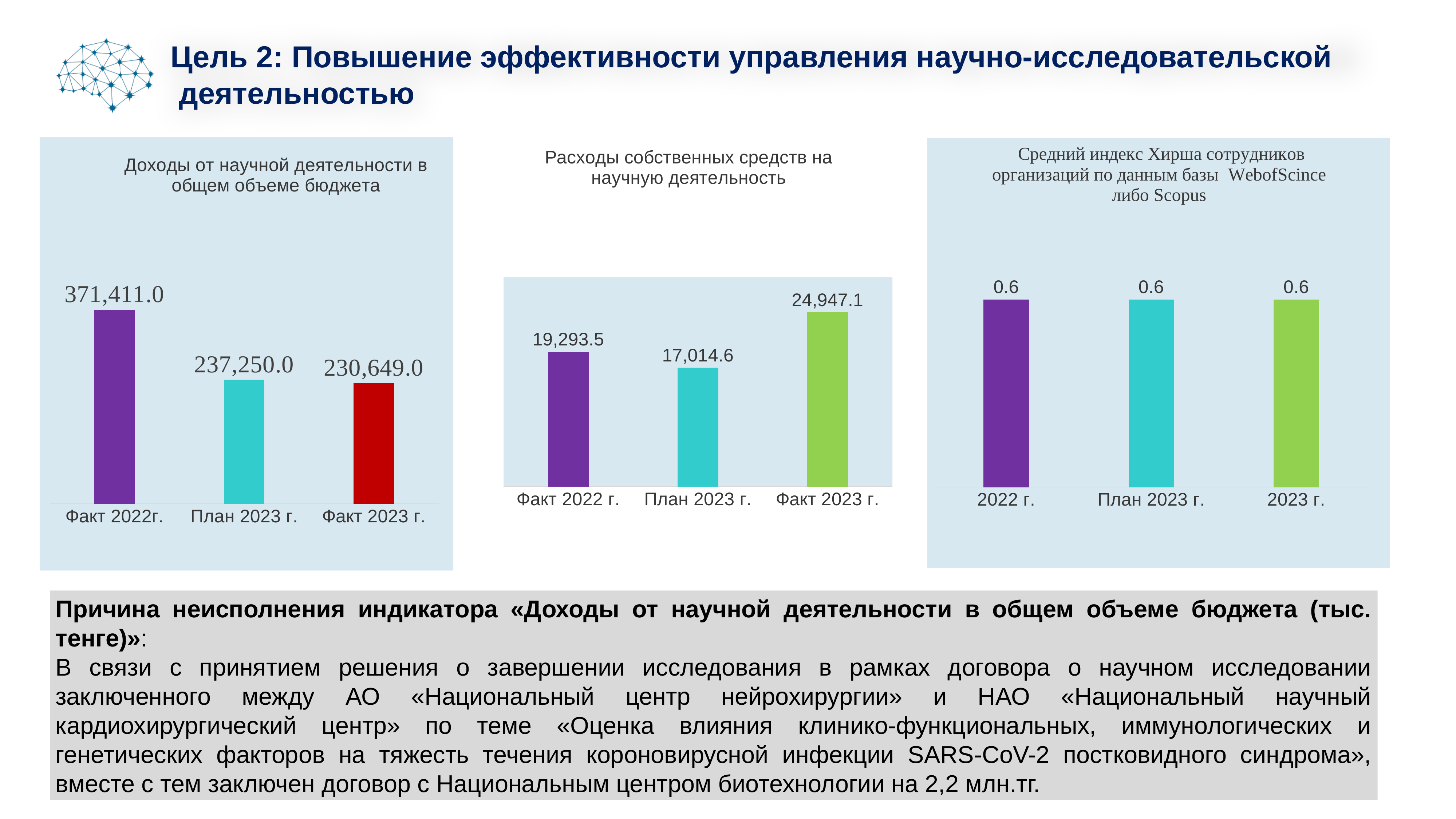
In the chart 'Расходы собственных средств на научную деятельность', what is the difference between Факт 2023 г. and План 2023 г.? 7,932.5 In the chart 'Доходы от научной деятельности в общем объеме бюджета', what is the difference between План 2023 г. and Факт 2023 г.? 6,601.0 In the chart 'Доходы от научной деятельности в общем объеме бюджета', what is the value for Факт 2023 г.? 230,649.0 In the chart 'Доходы от научной деятельности в общем объеме бюджета', what is the difference between Факт 2022г. and Факт 2023 г.? 140,762.0 In the chart 'Средний индекс Хирша сотрудников организаций', what is the value for 2022 г.? 0.6 In the chart 'Доходы от научной деятельности в общем объеме бюджета', which category has the highest value? Факт 2022г. In the chart 'Расходы собственных средств на научную деятельность', which is larger: Факт 2022 г. or Факт 2023 г.? Факт 2023 г. What type of chart is 'Расходы собственных средств на научную деятельность'? Bar chart In the chart 'Доходы от научной деятельности в общем объеме бюджета', what is the value for Факт 2022г.? 371,411.0 In the chart 'Расходы собственных средств на научную деятельность', what is the value for План 2023 г.? 17,014.6 In the chart 'Расходы собственных средств на научную деятельность', which category has the lowest value? План 2023 г. How many categories are shown in the chart 'Средний индекс Хирша сотрудников организаций'? 3